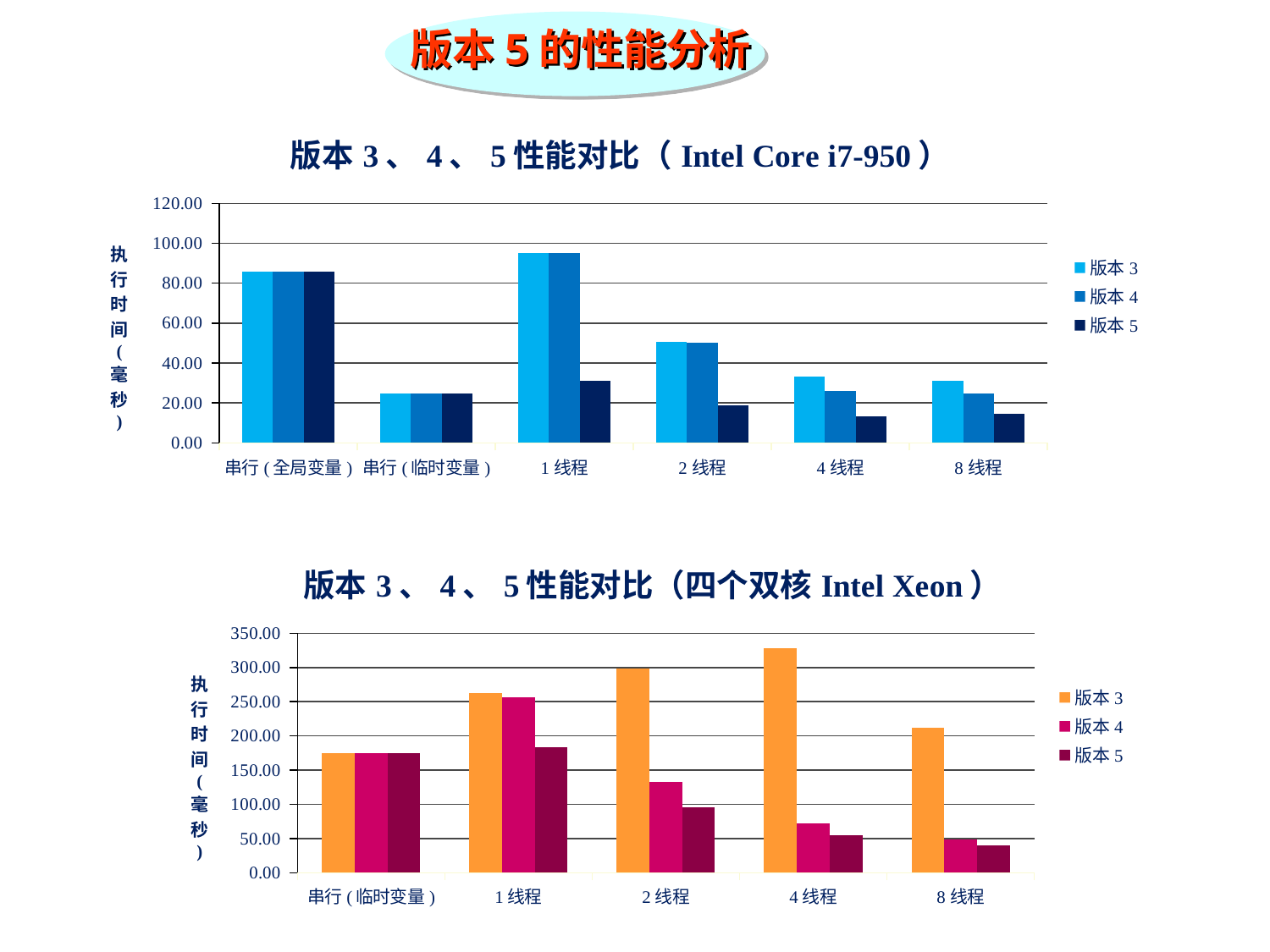
In the bottom chart (四个双核 Intel Xeon), is the value of 版本5 for 8线程 greater or less than 50.00? less In the top chart (Intel Core i7-950), is the value of 版本3 for 1线程 greater or less than 80.00? greater What kind of chart is the top chart (Intel Core i7-950)? bar chart In the top chart (Intel Core i7-950), do the values of 版本5 rise or fall from 1线程 to 8线程? fall In the bottom chart (四个双核 Intel Xeon), is the value of 版本3 for 4线程 greater or less than 300.00? greater How many series does the legend of the bottom chart (四个双核 Intel Xeon) list? 3 What is the y-axis label of the bottom chart (四个双核 Intel Xeon)? 执行时间（毫秒） In the bottom chart (四个双核 Intel Xeon), which category has the lowest value for 版本5? 8线程 In the top chart (Intel Core i7-950), which category has the highest value for 版本3? 1线程 How many categories are shown on the x axis of the top chart (Intel Core i7-950)? 6 In the bottom chart (四个双核 Intel Xeon), for 2线程, which is larger: 版本4 or 版本5? 版本4 How many categories are shown on the x axis of the bottom chart (四个双核 Intel Xeon)? 5